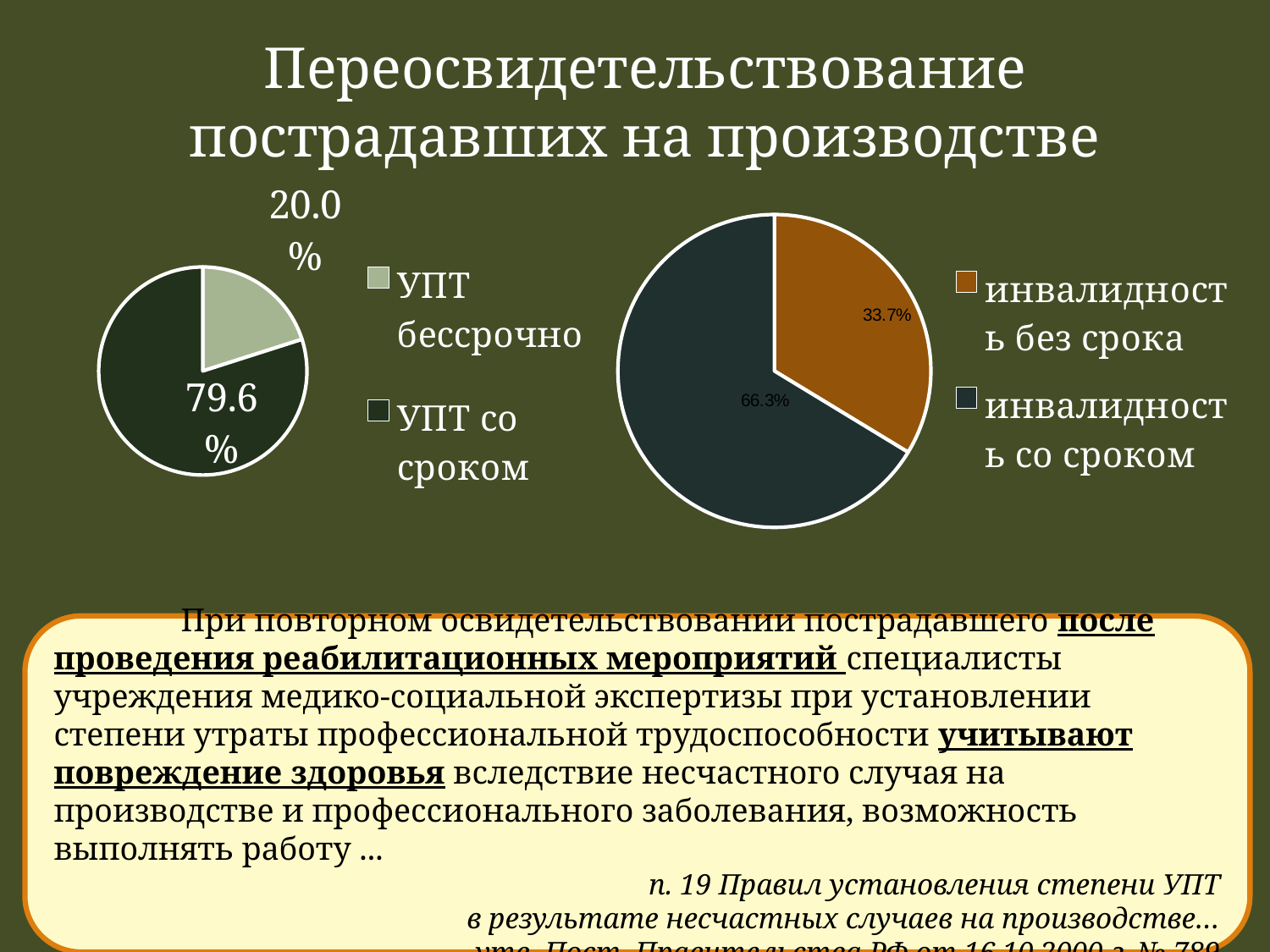
In the left pie chart, which category has the largest slice? УПТ со сроком In the left pie chart, what is the difference between the values for УПТ со сроком and УПТ бессрочно? 59.6% What type of chart is the right chart on the slide? pie chart In the right pie chart, what is the difference between the values for инвалидность со сроком and инвалидность без срока? 32.6% How many entries does the legend of the right pie chart list? 2 In the right pie chart, what is the value for инвалидность со сроком? 66.3% In the right pie chart, which category has the smallest slice? инвалидность без срока In the left pie chart, what is the value for УПТ бессрочно? 20.0% In the left pie chart, what is the value for УПТ со сроком? 79.6% How many slices does the left pie chart have? 2 In the right pie chart, which is larger: инвалидность без срока or инвалидность со сроком? инвалидность со сроком In the right pie chart, what is the value for инвалидность без срока? 33.7%